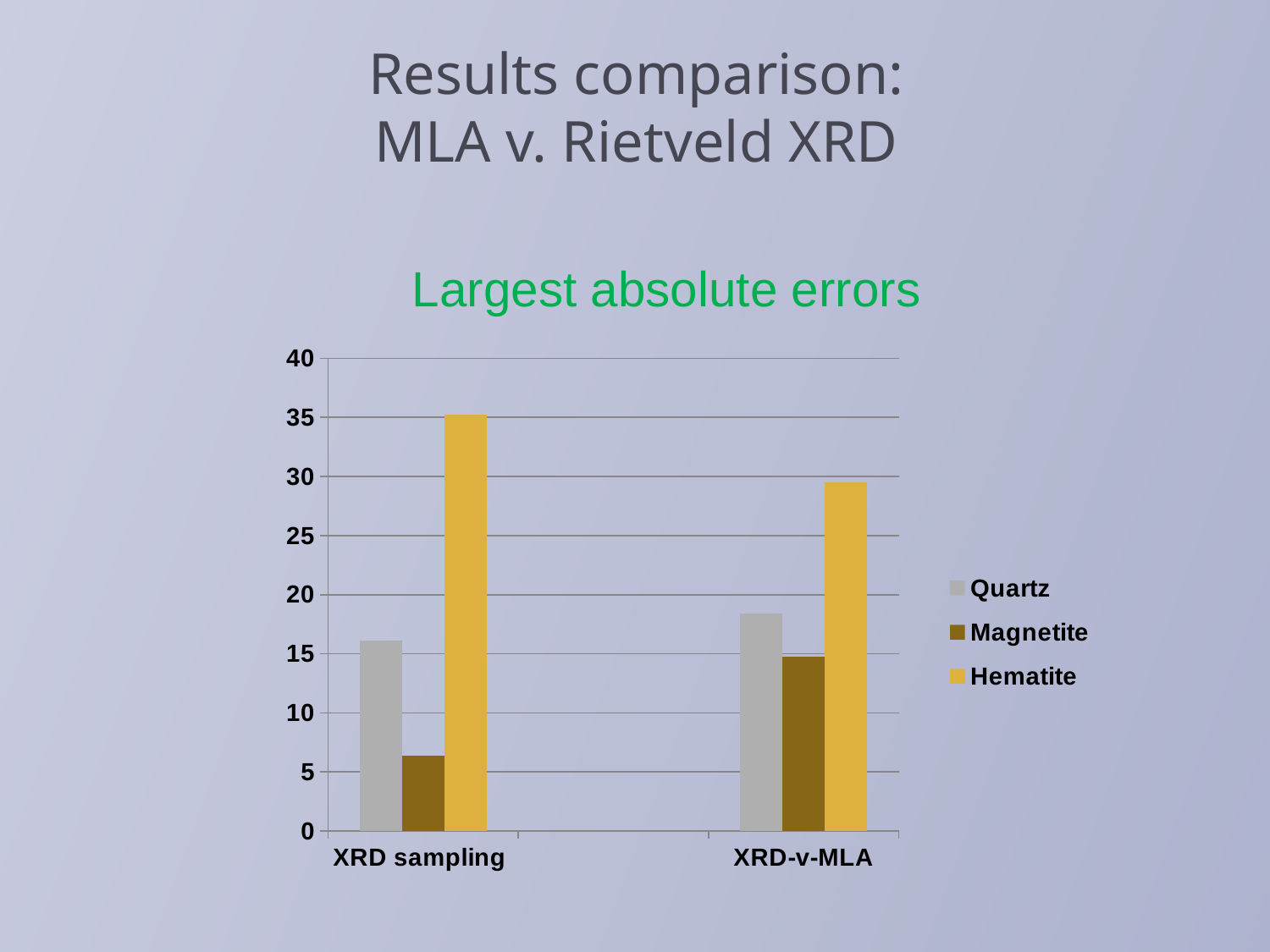
How many series does the legend list? 3 Which series has the highest value in the XRD sampling category? Hematite Which series has the lowest value in the XRD sampling category? Magnetite How many categories are shown on the x axis? 2 Is the Magnetite value for XRD sampling greater or less than 10? less What is the title of the chart? Largest absolute errors Which series has the lowest value in the XRD-v-MLA category? Magnetite Which is larger: the Hematite value for XRD sampling or the Hematite value for XRD-v-MLA? XRD sampling Which is larger: the Magnetite value for XRD sampling or the Magnetite value for XRD-v-MLA? XRD-v-MLA What kind of chart is shown under the title "Largest absolute errors"? bar chart